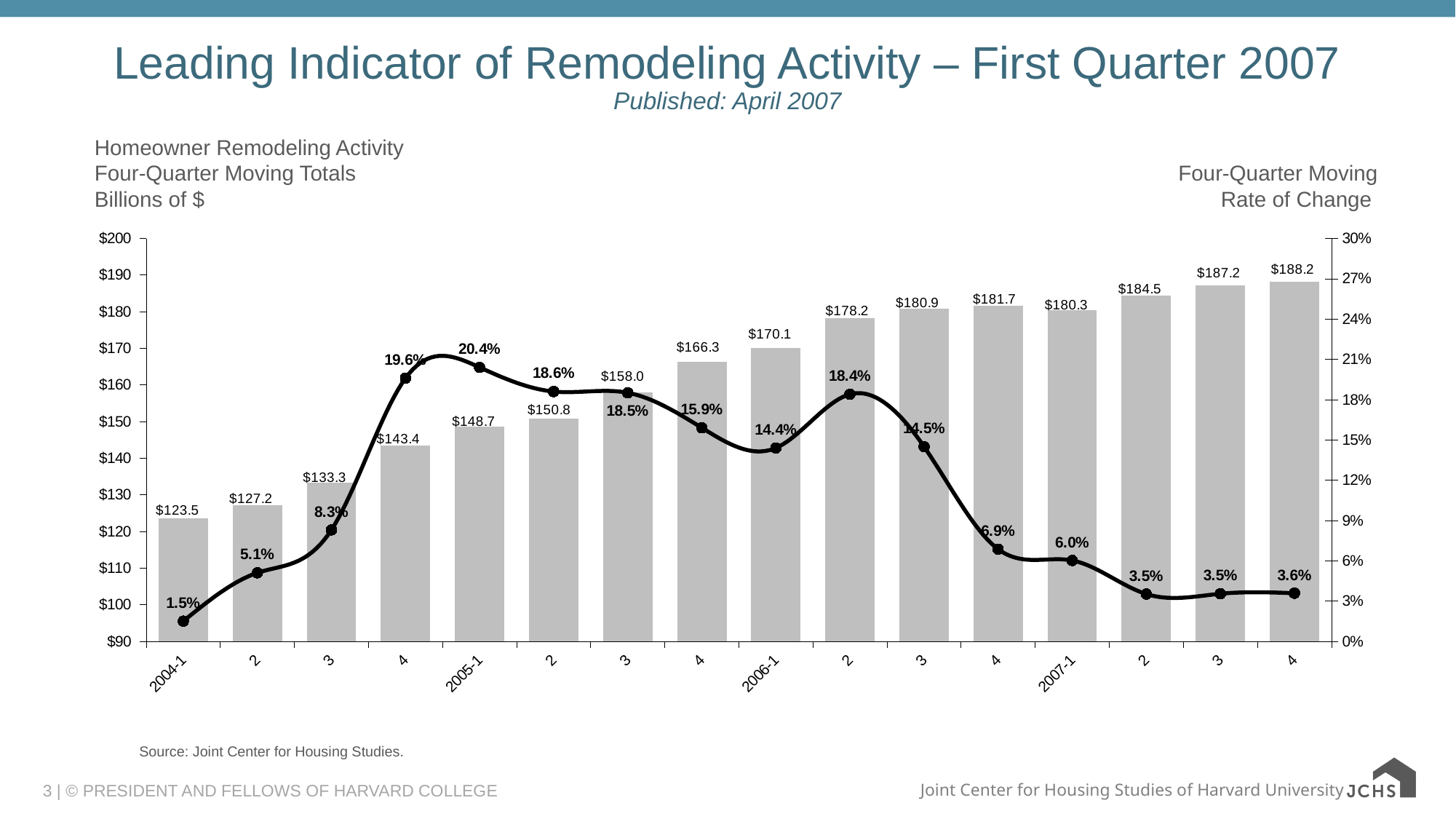
Does the four-quarter moving rate of change rise or fall from 2006-2 to 2007-2? fall What is the four-quarter moving total for 2004-1? $123.5 What kind of chart is used to show the four-quarter moving totals? bar chart What is the four-quarter moving total for 2006-2? $178.2 What is the four-quarter moving rate of change for 2005-1? 20.4% What is the difference between the rate of change for 2005-1 and 2007-4? 16.8% What is the difference between the four-quarter moving totals for 2007-4 and 2004-1? $64.7 Which quarter has the highest four-quarter moving total? 2007-4 What is the unit of the left axis? Billions of $ Which is larger, the four-quarter moving total for 2006-4 or for 2007-1? 2006-4 Which quarter has the lowest four-quarter moving rate of change? 2004-1 How many quarters are plotted on the chart? 16